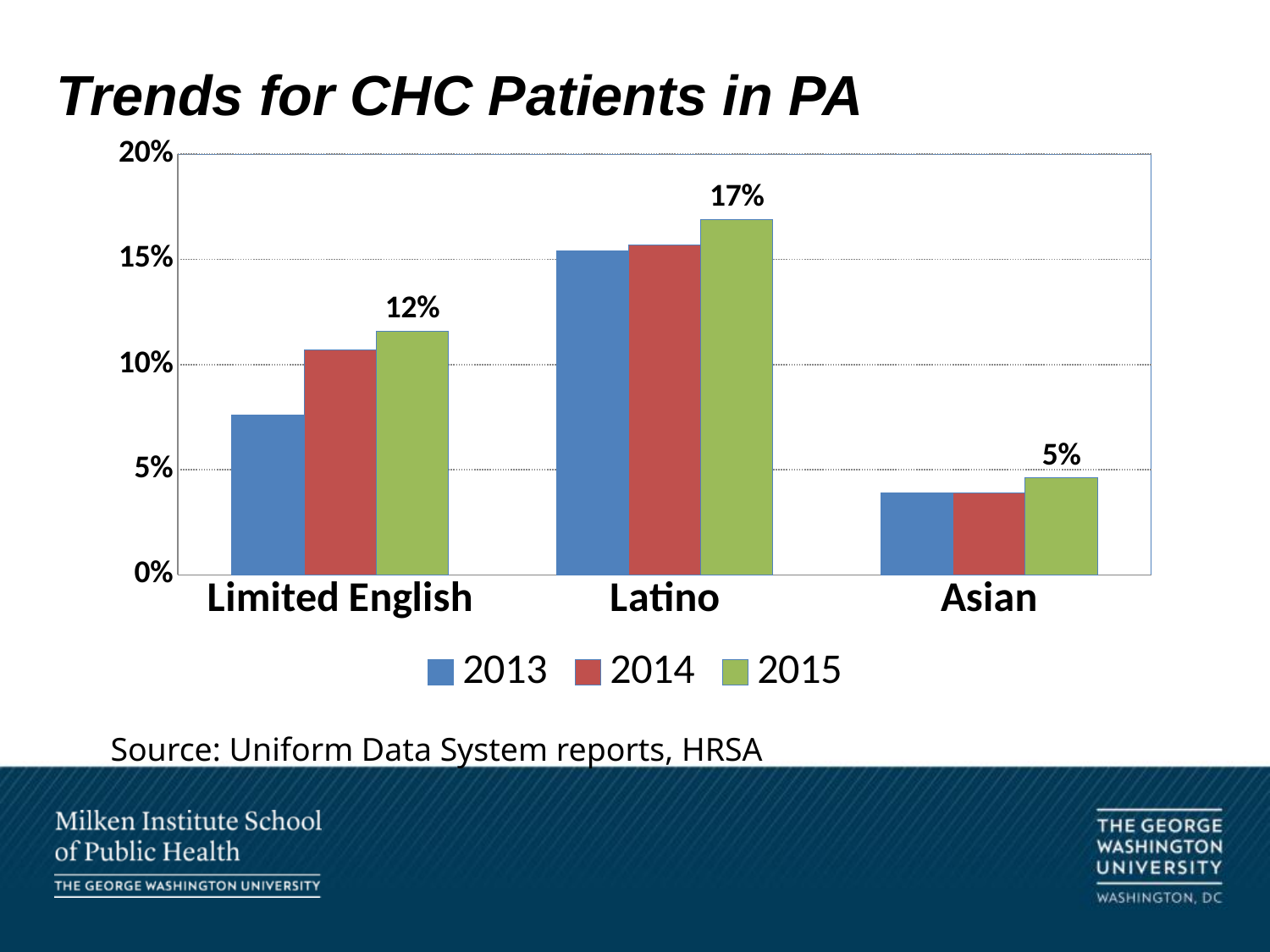
What is the difference between the 2015 values for Latino and Asian? 12 percentage points How many categories are shown on the x axis? 3 Is the value for Latino in 2013 greater or less than 10%? greater Is the value for Limited English in 2013 greater or less than 10%? less What is the value for Latino in 2015? 17% What is the value for Asian in 2015? 5% Which is larger in 2015, Limited English or Asian? Limited English What is the value for Limited English in 2015? 12% Which category has the highest value in 2015? Latino How many series does the legend list? 3 Which category has the lowest value in 2015? Asian Do the values for Limited English rise or fall from 2013 to 2015? rise